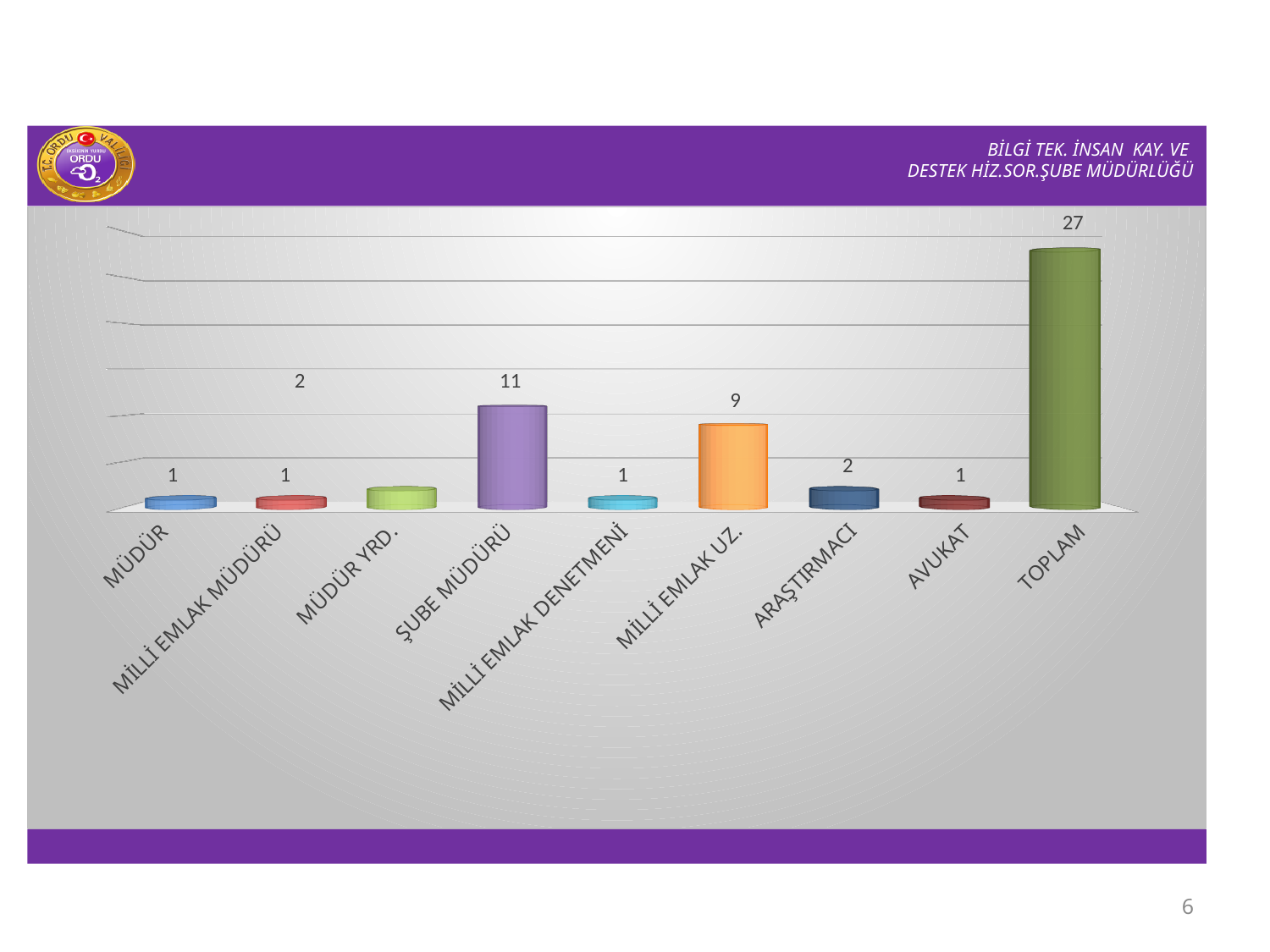
What is the value for MİLLİ EMLAK UZ.? 9 What is the value for MÜDÜR YRD.? 2 Which is larger, the value for MİLLİ EMLAK UZ. or the value for ARAŞTIRMACI? MİLLİ EMLAK UZ. Excluding TOPLAM, which category has the highest value? ŞUBE MÜDÜRÜ What is the difference between the values for ŞUBE MÜDÜRÜ and MİLLİ EMLAK UZ.? 2 How many categories are shown on the x axis? 9 What is the value for AVUKAT? 1 Which category has the highest value? TOPLAM What is the value for ŞUBE MÜDÜRÜ? 11 What kind of chart is shown on the slide? Bar chart What is the value for TOPLAM? 27 What is the value for ARAŞTIRMACI? 2